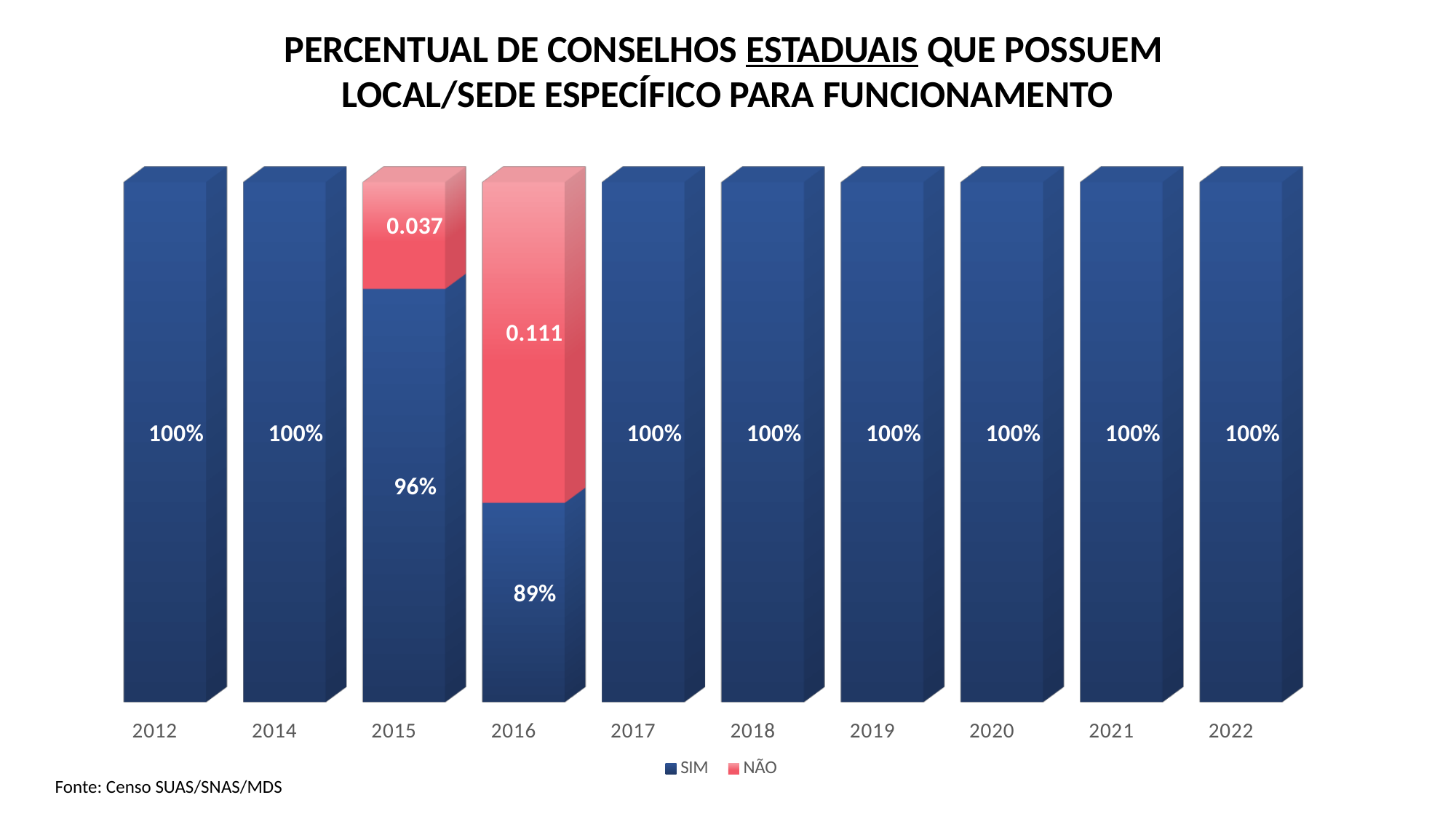
What is the NÃO value labelled for 2016? 0.111 What is the difference between the SIM values for 2015 and 2016? 7% What is the SIM value for 2019? 100% Which series is shown in red? NÃO Which year has the lowest SIM value? 2016 What is the SIM value for 2016? 89% What is the SIM value for 2015? 96% How many years are shown on the x axis? 10 Which is larger, the SIM value for 2015 or for 2016? 2015 What is the NÃO value labelled for 2015? 0.037 How many series does the legend list? 2 What kind of chart is shown? Stacked bar chart